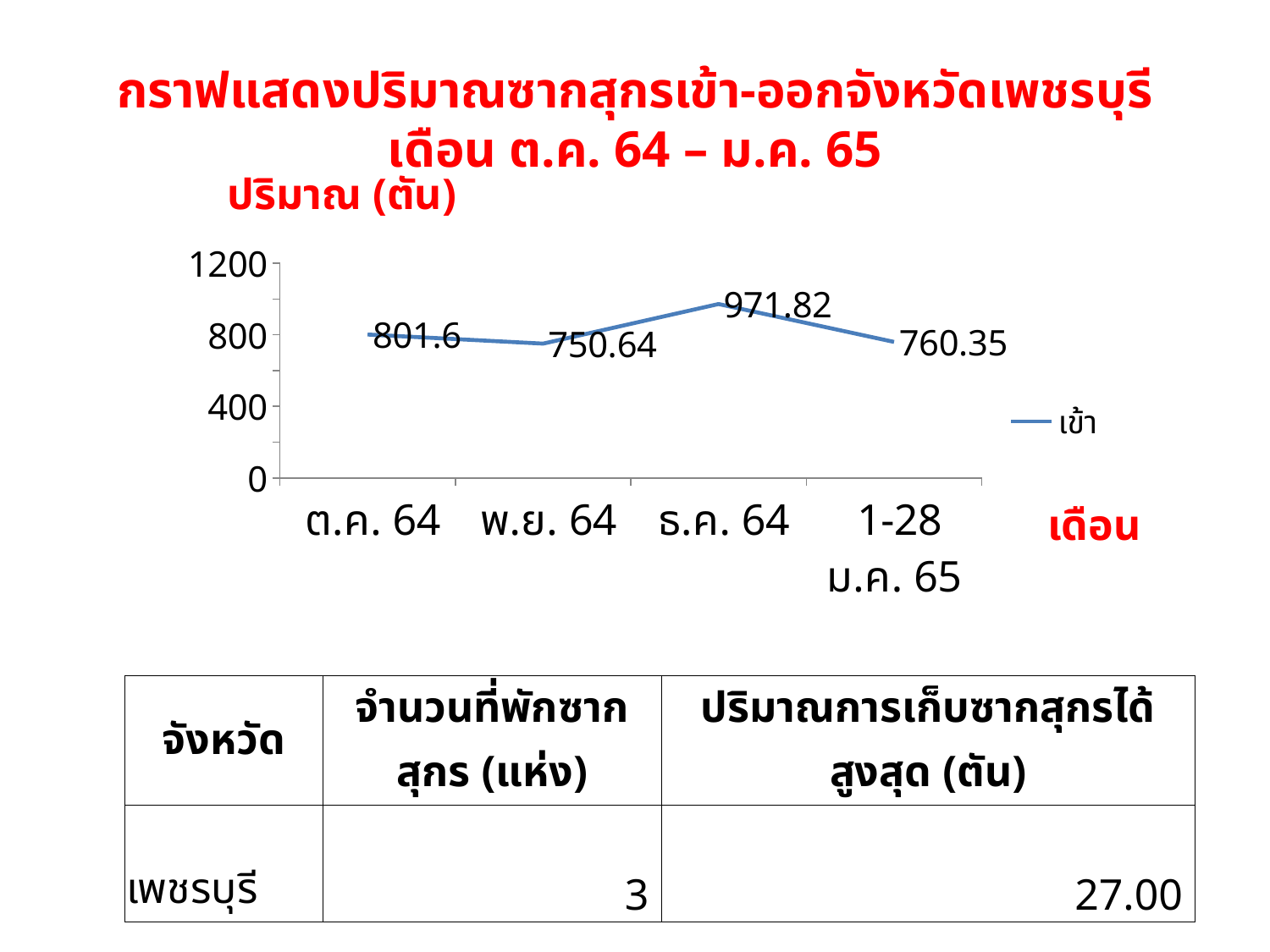
What is the value for ธ.ค. 64 in the line chart? 971.82 What is the value for 1-28 ม.ค. 65 in the line chart? 760.35 What is the value for พ.ย. 64 in the line chart? 750.64 Is the value for ธ.ค. 64 greater or less than 800? greater What is the difference between the values for ธ.ค. 64 and พ.ย. 64? 221.18 Which month has the lowest value in the line chart? พ.ย. 64 What is the value for ต.ค. 64 in the line chart? 801.6 What type of chart is shown on the slide? line chart Which month has the highest value in the line chart? ธ.ค. 64 How many series does the legend of the chart list? 1 How many data points are plotted in the line chart? 4 Which is larger, the value for ต.ค. 64 or the value for 1-28 ม.ค. 65? ต.ค. 64